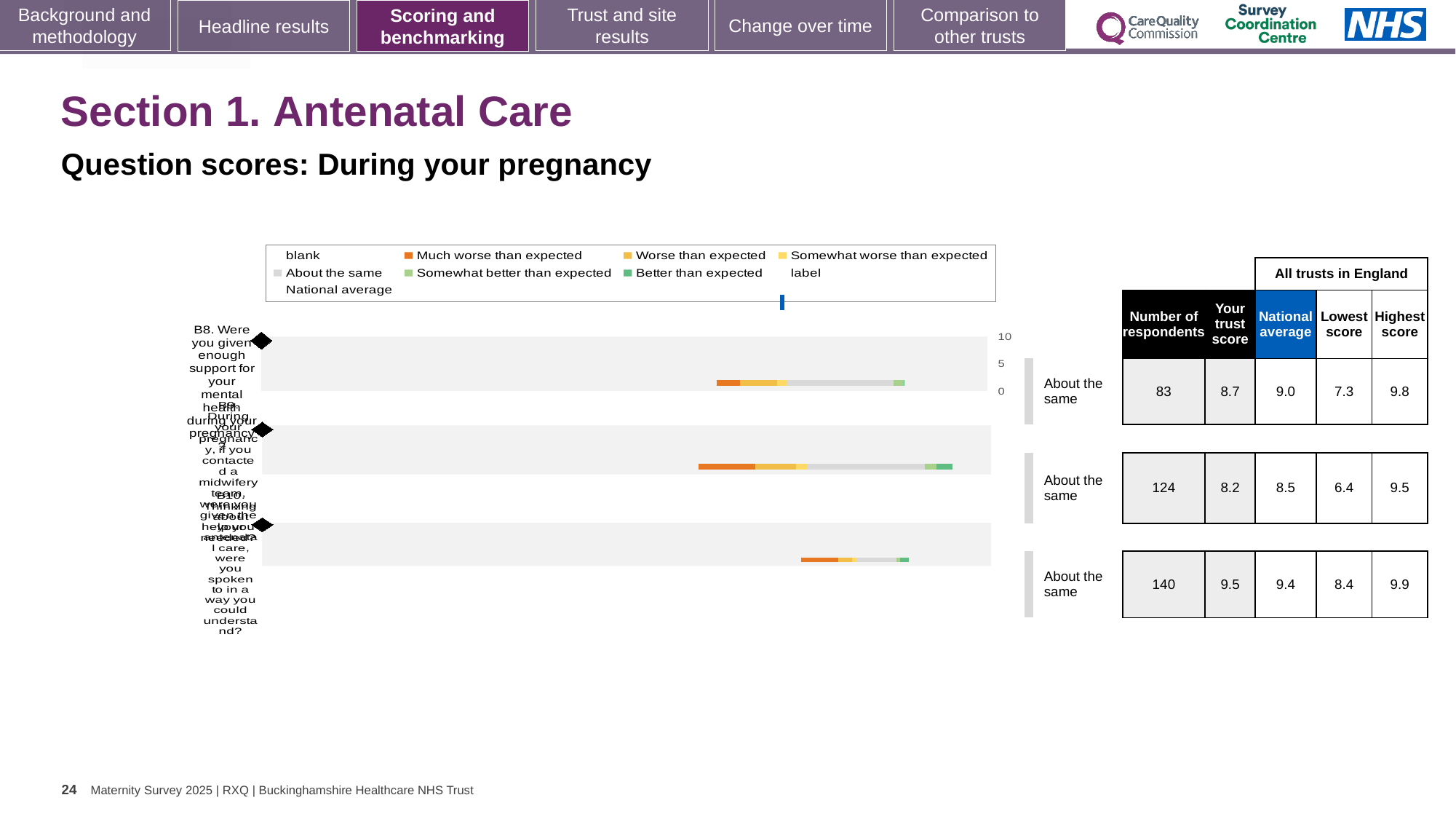
In the legend, which colour represents 'Much worse than expected'? Orange Which row has the lowest trust score? The middle (second) row, 8.2 What is the lowest score across all trusts in England for the middle (second) row? 6.4 What is the national average for the bottom (third) row? 9.4 What is the difference between the highest score and the lowest score for the middle (second) row? 3.1 For the bottom (third) row, which is larger: the trust score or the national average? The trust score (9.5) What is the number of respondents for question B8 (the top row)? 83 What kind of chart is shown on the slide? Bar chart How many question rows are plotted in the chart? 3 Which row has the highest number of respondents? The bottom (third) row, 140 What is the subtitle of the chart on the slide? Question scores: During your pregnancy What is the trust score for question B8 (the top row)? 8.7